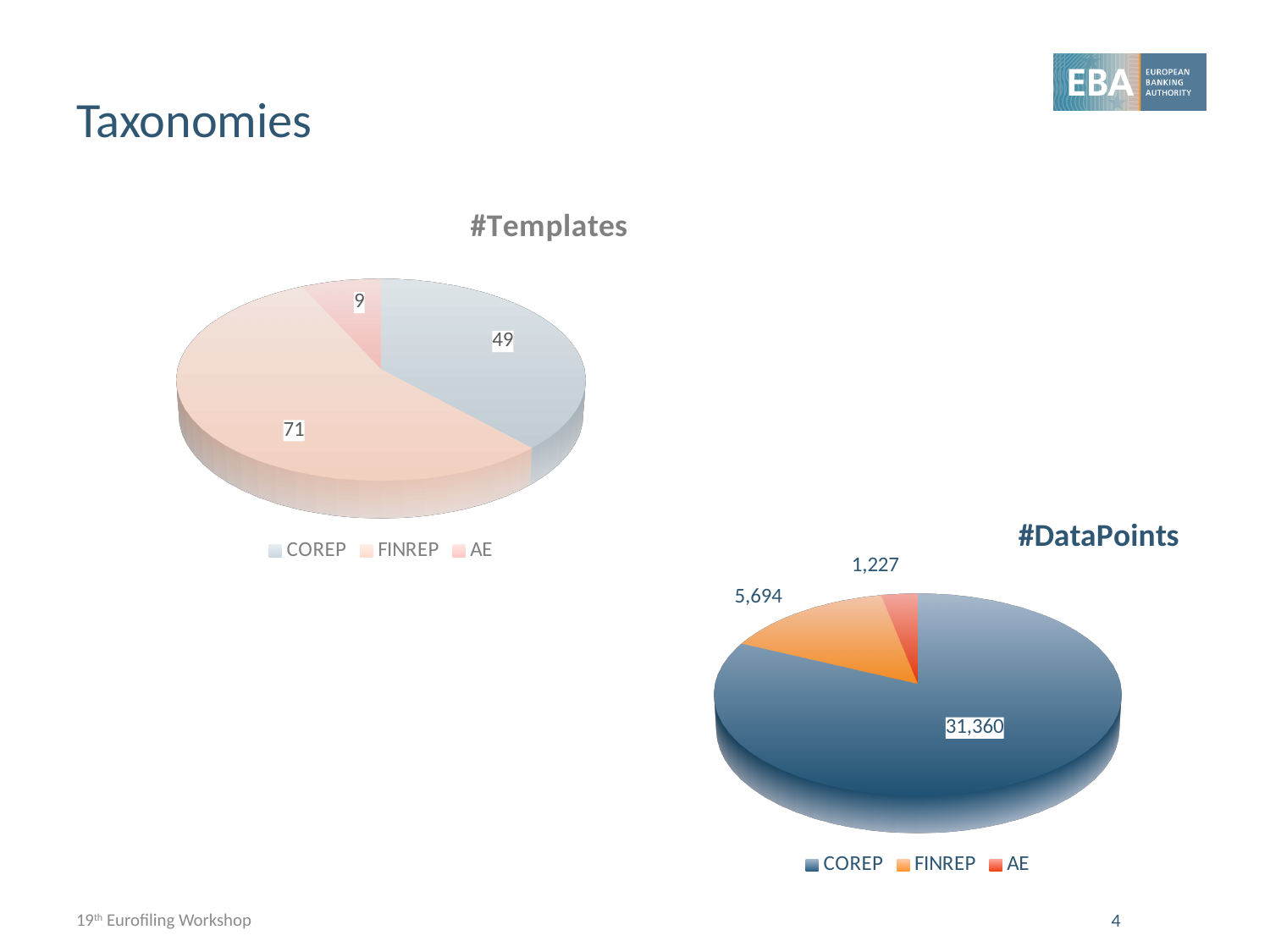
In the #Templates chart, which is larger, COREP or AE? COREP In the #DataPoints chart, what is the value for FINREP? 5,694 In the #Templates chart, what share of the total does FINREP represent, to the nearest whole percent? 55% In the #Templates chart, what is the value for AE? 9 In the #Templates chart, which category has the largest slice? FINREP In the #Templates chart, what is the value for FINREP? 71 In the #DataPoints chart, what is the difference between the COREP and FINREP values? 25,666 In the #DataPoints chart, which category has the smallest slice? AE How many categories does the #DataPoints chart show? 3 In the #DataPoints chart, what is the value for COREP? 31,360 In the #Templates chart, what is the difference between the FINREP and COREP values? 22 What kind of chart is the #Templates chart? Pie chart